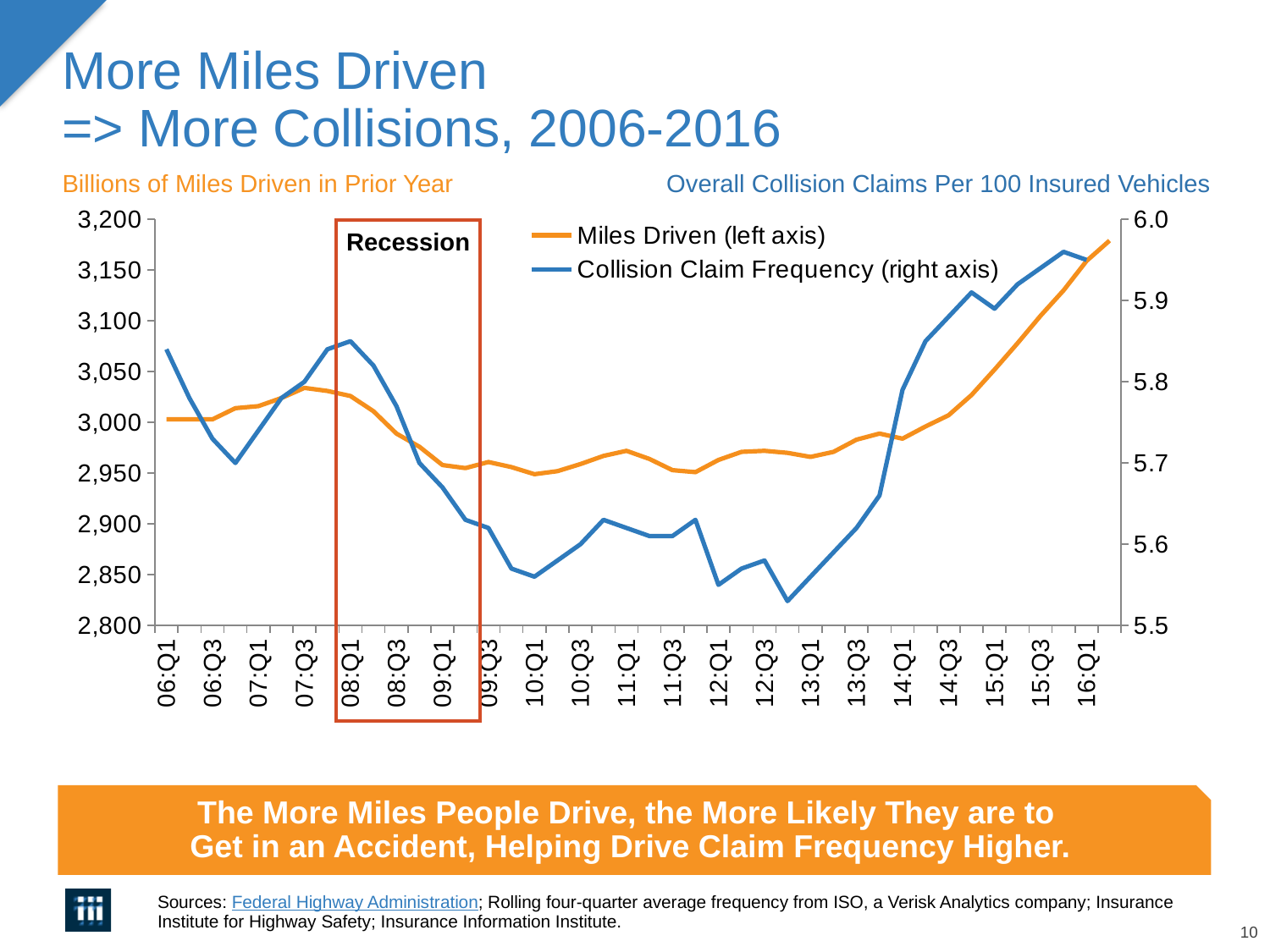
What kind of chart is shown on the slide? Line chart What is the label above the left axis of the chart? Billions of Miles Driven in Prior Year Is the value for Collision Claim Frequency at 12:Q1 greater or less than 5.6? less At which x-axis label does the Miles Driven series reach its highest value? 16:Q1 Which series is plotted on the right axis according to the legend? Collision Claim Frequency Does the Miles Driven series rise or fall from 13:Q3 to 16:Q1? Rise Is the value for Miles Driven at 16:Q1 greater or less than 3,150? greater Does the Collision Claim Frequency series rise or fall from 08:Q1 to 10:Q1? Fall Is the value for Collision Claim Frequency at 15:Q3 greater or less than 5.9? greater Which is larger for Collision Claim Frequency: the value at 08:Q1 or the value at 12:Q1? 08:Q1 How many series does the legend list? 2